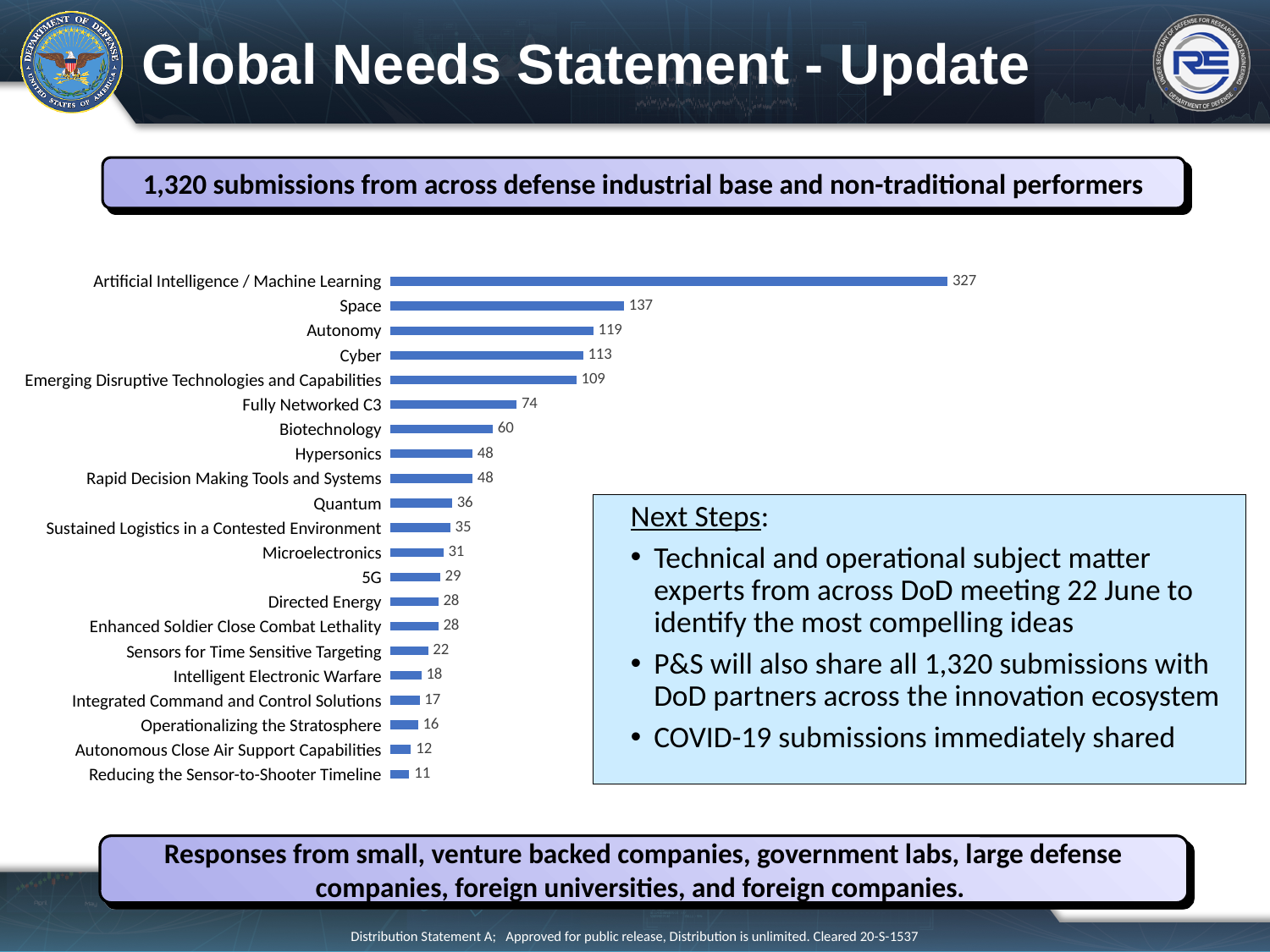
How many categories are shown in the chart? 21 What is the value for Quantum? 36 What is the value for Space? 137 What is the value for Artificial Intelligence / Machine Learning? 327 What is the value for Biotechnology? 60 Which category has the lowest value? Reducing the Sensor-to-Shooter Timeline What is the difference between the values for Artificial Intelligence / Machine Learning and Cyber? 214 What kind of chart is shown on the slide? Bar chart Which category has the highest value? Artificial Intelligence / Machine Learning Which is larger, the value for Fully Networked C3 or the value for Biotechnology? Fully Networked C3 What is the value for Hypersonics? 48 What is the difference between the values for Space and Autonomy? 18